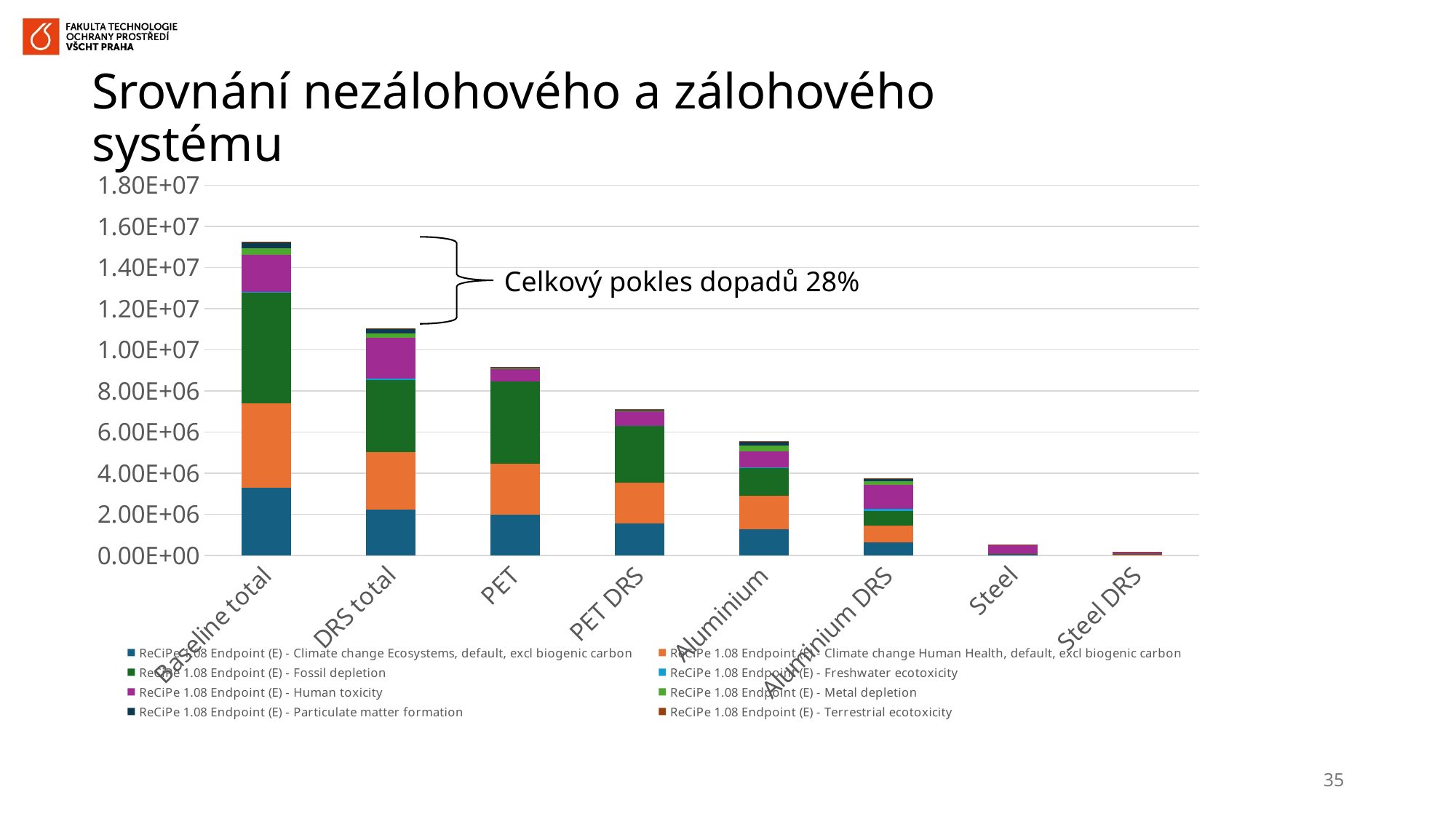
Is the total value for Baseline total greater or less than 1.40E+07? greater How many series does the chart legend list? 8 Which stacked bar is taller, Aluminium or Aluminium DRS? Aluminium Which category has the smallest stacked bar? Steel DRS Which stacked bar is taller, PET or PET DRS? PET Which category has the tallest stacked bar? Baseline total How many categories are shown on the x axis of the chart? 8 Is the total value for DRS total greater or less than 1.00E+07? greater What does the annotation next to the bracket between the Baseline total and DRS total bars say? Celkový pokles dopadů 28% What kind of chart is shown on the slide? Stacked bar chart Is the total value for Aluminium DRS greater or less than 4.00E+06? less What colour represents the series 'ReCiPe 1.08 Endpoint (E) - Fossil depletion' in the chart? Dark green